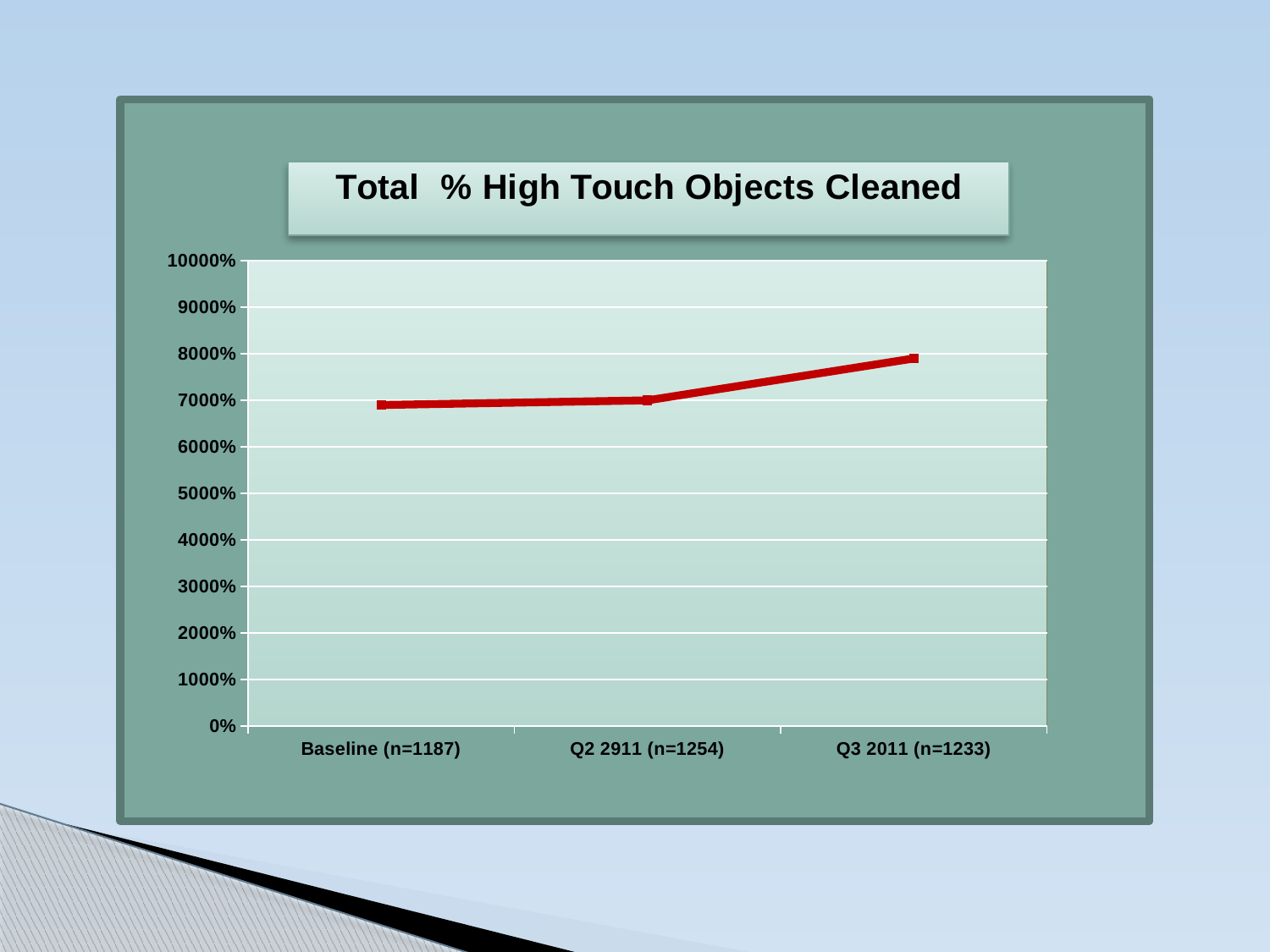
Do the values rise or fall from Baseline to Q3 2011 along the x axis? rise What colour is the plotted line? red Is the value for Q2 2911 (n=1254) greater or less than 8000%? less What kind of chart is shown on the slide? line chart Which is larger, the value for Baseline (n=1187) or the value for Q3 2011 (n=1233)? Q3 2011 (n=1233) How many data points are plotted on the line? 3 Is the value for Baseline (n=1187) greater or less than 6000%? greater Which category has the highest value? Q3 2011 (n=1233) Is the value for Baseline (n=1187) greater or less than 8000%? less What is the title of the chart? Total % High Touch Objects Cleaned